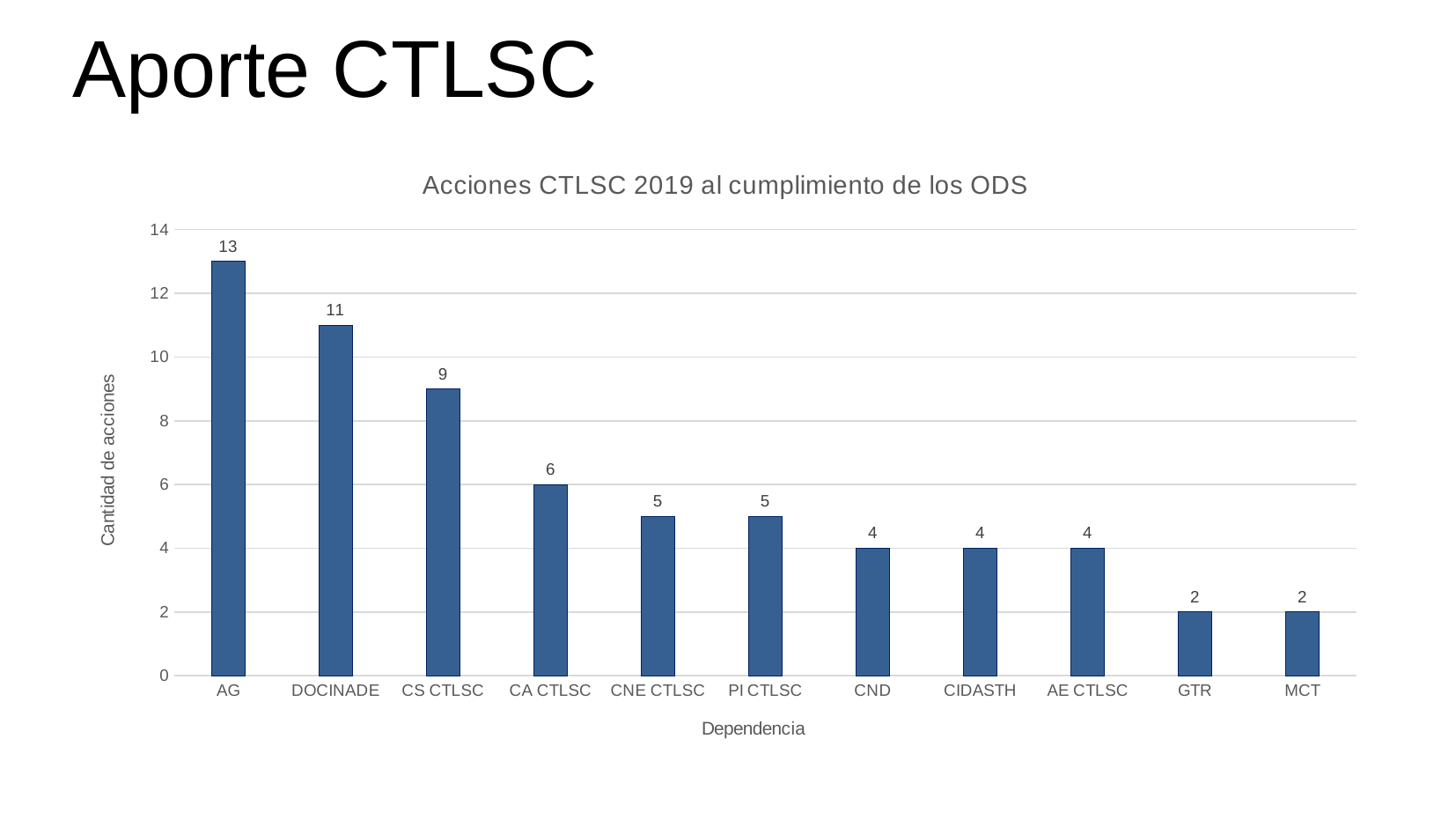
What is the value for CND? 4 What is the difference between the values for AG and DOCINADE? 2 What is the difference between the values for CA CTLSC and GTR? 4 Which is larger, the value for DOCINADE or the value for CNE CTLSC? DOCINADE What kind of chart is this? bar chart Do the values rise or fall from left to right along the x axis? fall Which category has the highest value? AG What is the value for CS CTLSC? 9 How many categories are shown on the x axis? 11 What is the value for AG? 13 Is the value for CS CTLSC greater or less than 8? greater What is the title of the chart? Acciones CTLSC 2019 al cumplimiento de los ODS